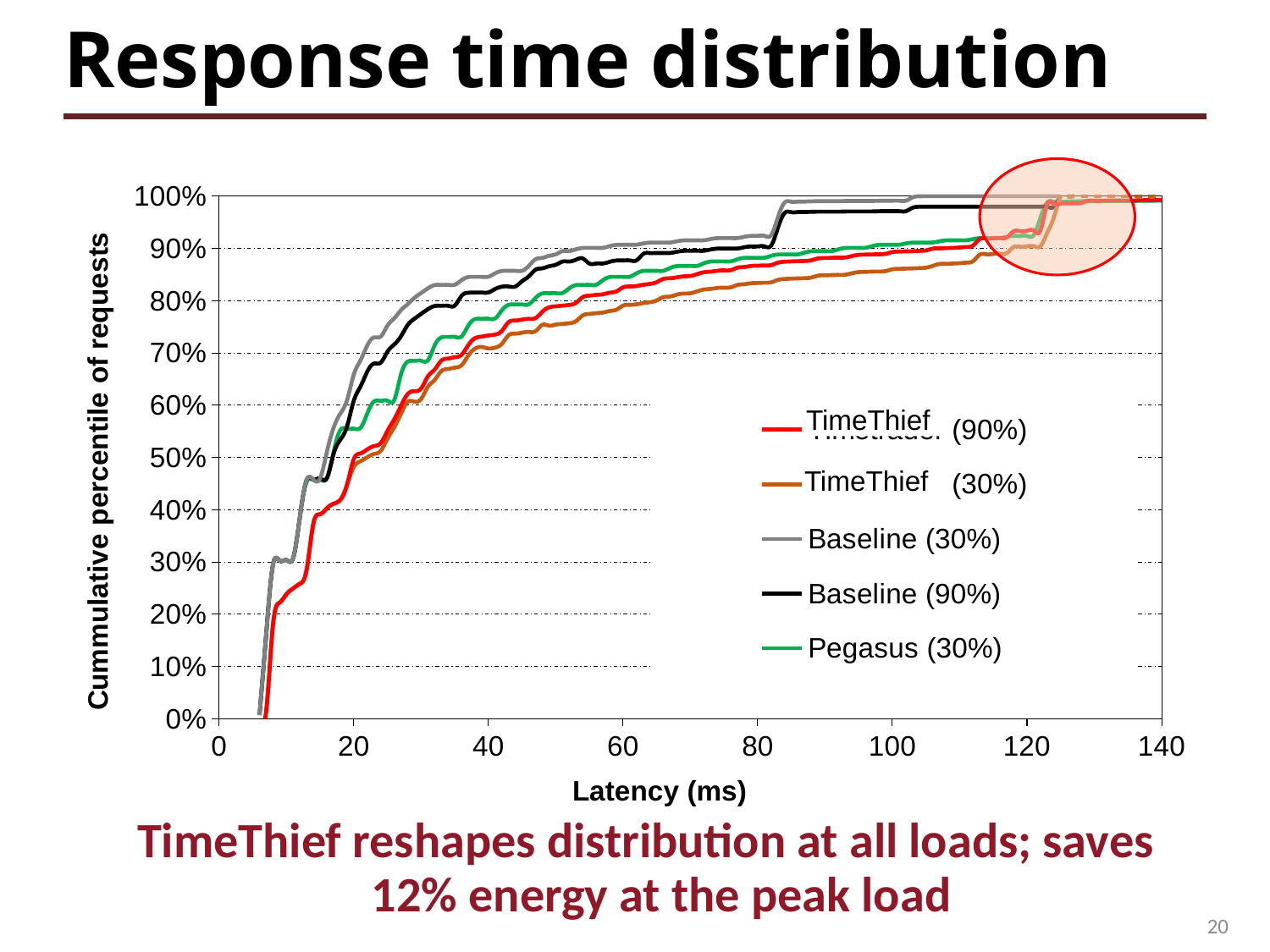
Do the values of the Baseline (30%) series rise or fall as latency increases? Rise Is the value for TimeThief (30%) at a latency of 100 ms greater or less than 90%? less What is the title of the chart? Response time distribution What kind of chart is shown on the slide? Line chart Is the value for Baseline (30%) at a latency of 40 ms greater or less than 80%? greater Is the value for Baseline (90%) at a latency of 100 ms greater or less than 90%? greater At a latency of 60 ms, which is higher: Baseline (30%) or TimeThief (30%)? Baseline (30%) Which series has the highest cumulative percentile at a latency of 40 ms? Baseline (30%) How many series does the legend list? 5 Which series has the lowest cumulative percentile at a latency of 60 ms? TimeThief (30%) What is the label of the x axis? Latency (ms)